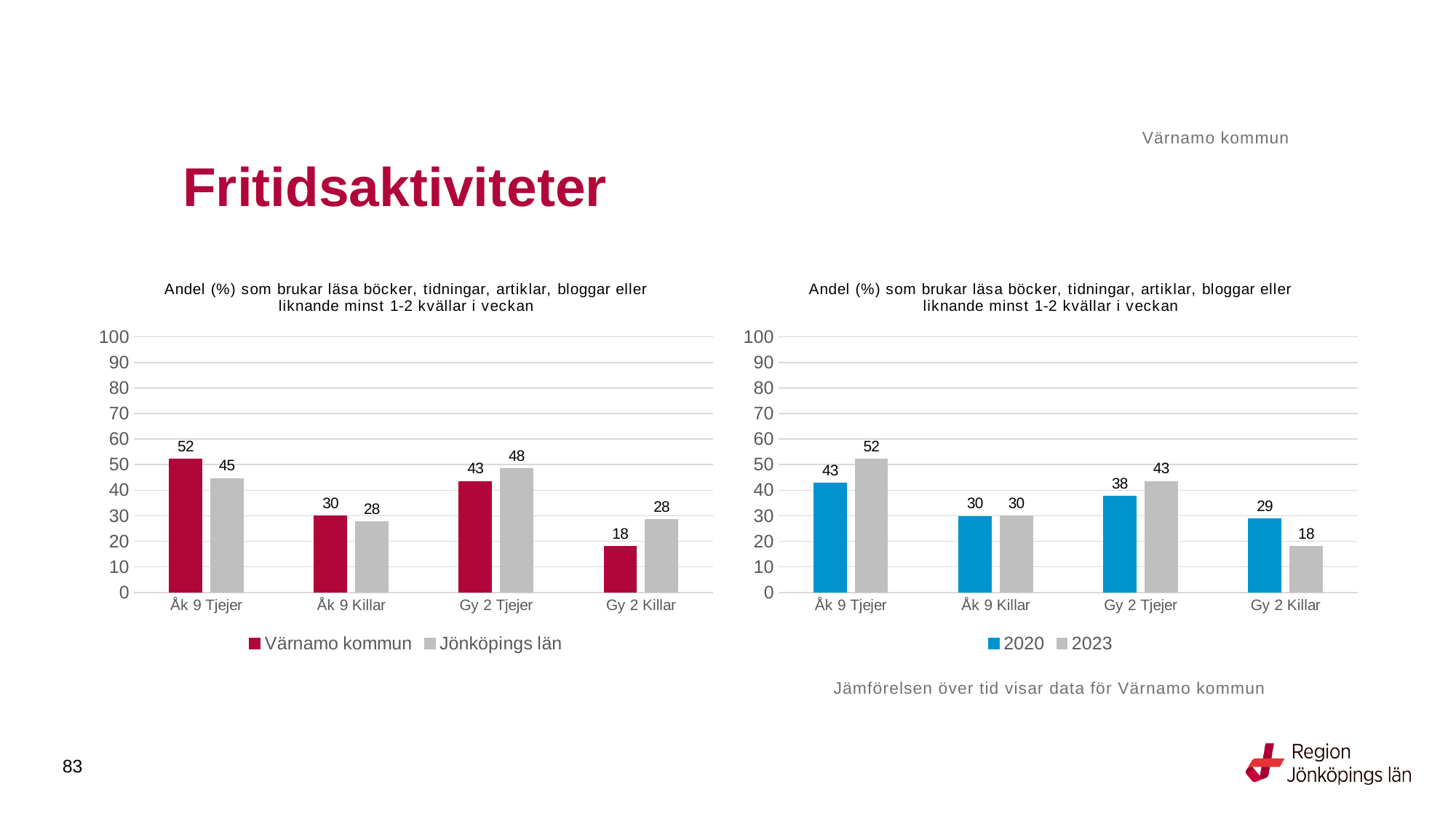
In the right chart, what is the value for 2020 for Gy 2 Tjejer? 38 In the right chart, what is the difference between 2023 and 2020 for Åk 9 Tjejer? 9 What type of chart is the left chart? Bar chart How many categories are shown on the x axis of the left chart? 4 In the left chart, what is the value for Jönköpings län for Gy 2 Killar? 28 In the left chart, what is the difference between Värnamo kommun and Jönköpings län for Gy 2 Killar? 10 In the left chart, which is larger for Gy 2 Tjejer: Värnamo kommun or Jönköpings län? Jönköpings län In the left chart, which category has the lowest value for Värnamo kommun? Gy 2 Killar In the right chart, which category has the highest value for 2023? Åk 9 Tjejer In the right chart, which is larger for Gy 2 Killar: 2020 or 2023? 2020 How many series does the legend of the right chart list? 2 In the left chart, what is the value for Värnamo kommun for Åk 9 Tjejer? 52